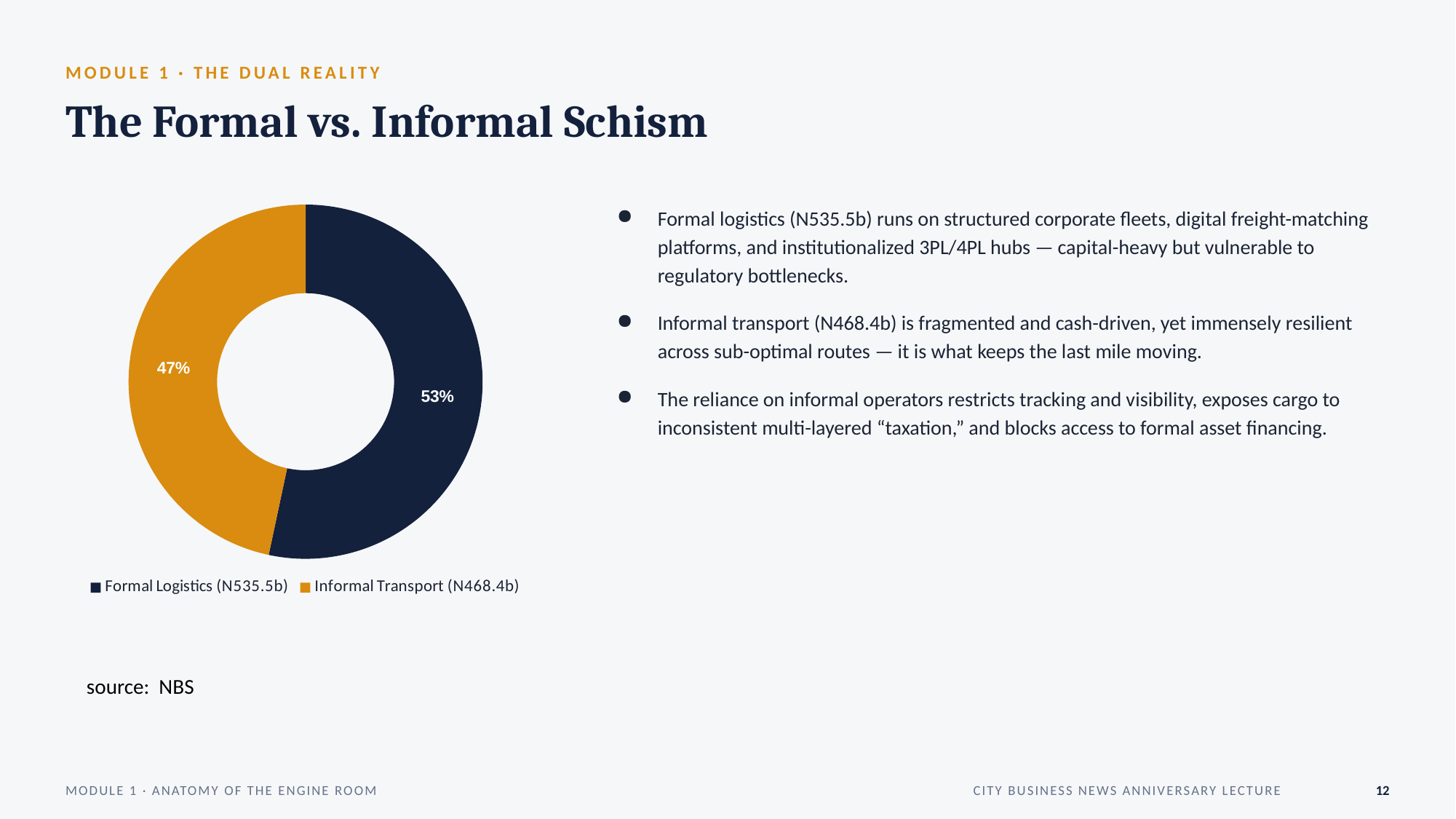
What share of the donut chart does Informal Transport (N468.4b) represent? 47% What is the source cited for the chart? NBS What colour is the Informal Transport segment in the chart? Orange Which segment of the chart is the smallest? Informal Transport (N468.4b) Which is larger, the Formal Logistics segment or the Informal Transport segment? Formal Logistics Is the share for Informal Transport greater or less than 50%? less How many entries does the chart legend list? 2 Which segment of the chart is the largest? Formal Logistics (N535.5b) What is the difference in percentage points between the Formal Logistics and Informal Transport segments? 6 percentage points How many segments does the chart have? 2 What kind of chart is shown on the slide? Donut (pie) chart What share of the donut chart does Formal Logistics (N535.5b) represent? 53%